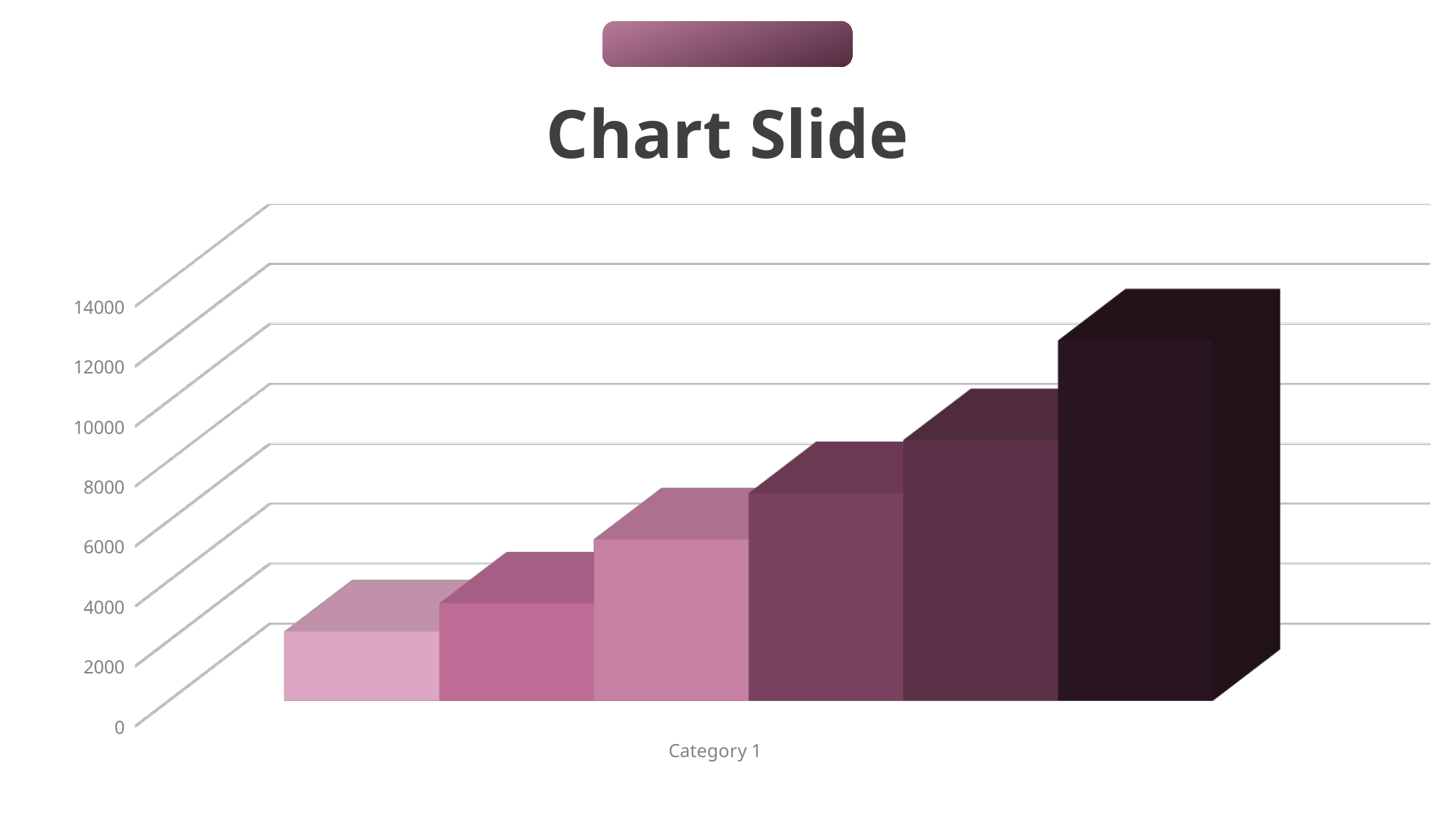
Which bar is the shortest in the chart? the leftmost bar Is the value of the rightmost bar greater or less than 10000? greater Which bar is the tallest in the chart? the rightmost bar Do the bar heights rise or fall from left to right across the chart? rise What is the highest value labelled on the vertical axis? 14000 How many bars are plotted in the chart? 6 Is the value of the third bar from the left greater or less than 4000? greater What is the title of the slide containing the chart? Chart Slide Is the value of the leftmost bar greater or less than 4000? less What is the label of the category shown on the x axis? Category 1 What kind of chart is shown on the slide? bar chart Which is taller, the leftmost bar or the rightmost bar? the rightmost bar